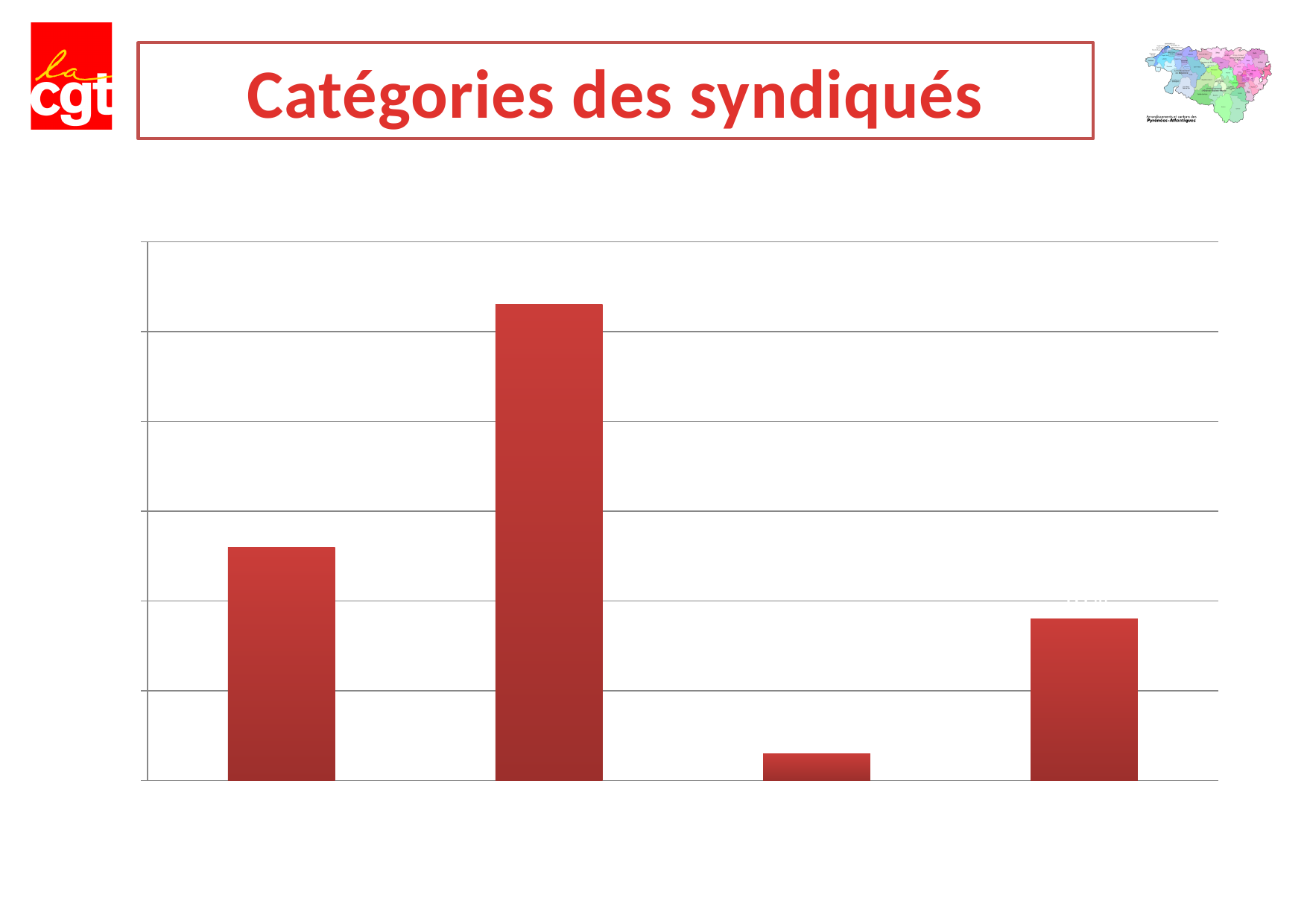
Which bar is the tallest in the chart, counting from the left? the second bar What is the title shown above the chart on the slide? Catégories des syndiqués Which bar is the shortest in the chart, counting from the left? the third bar Which is shorter, the third bar from the left or the first bar from the left? the third bar Which is taller, the first bar from the left or the fourth bar from the left? the first bar How many bars are plotted in the chart? 4 What colour are the bars in the chart? red Which is taller, the second bar from the left or the fourth bar from the left? the second bar What kind of chart is shown on the slide? bar chart